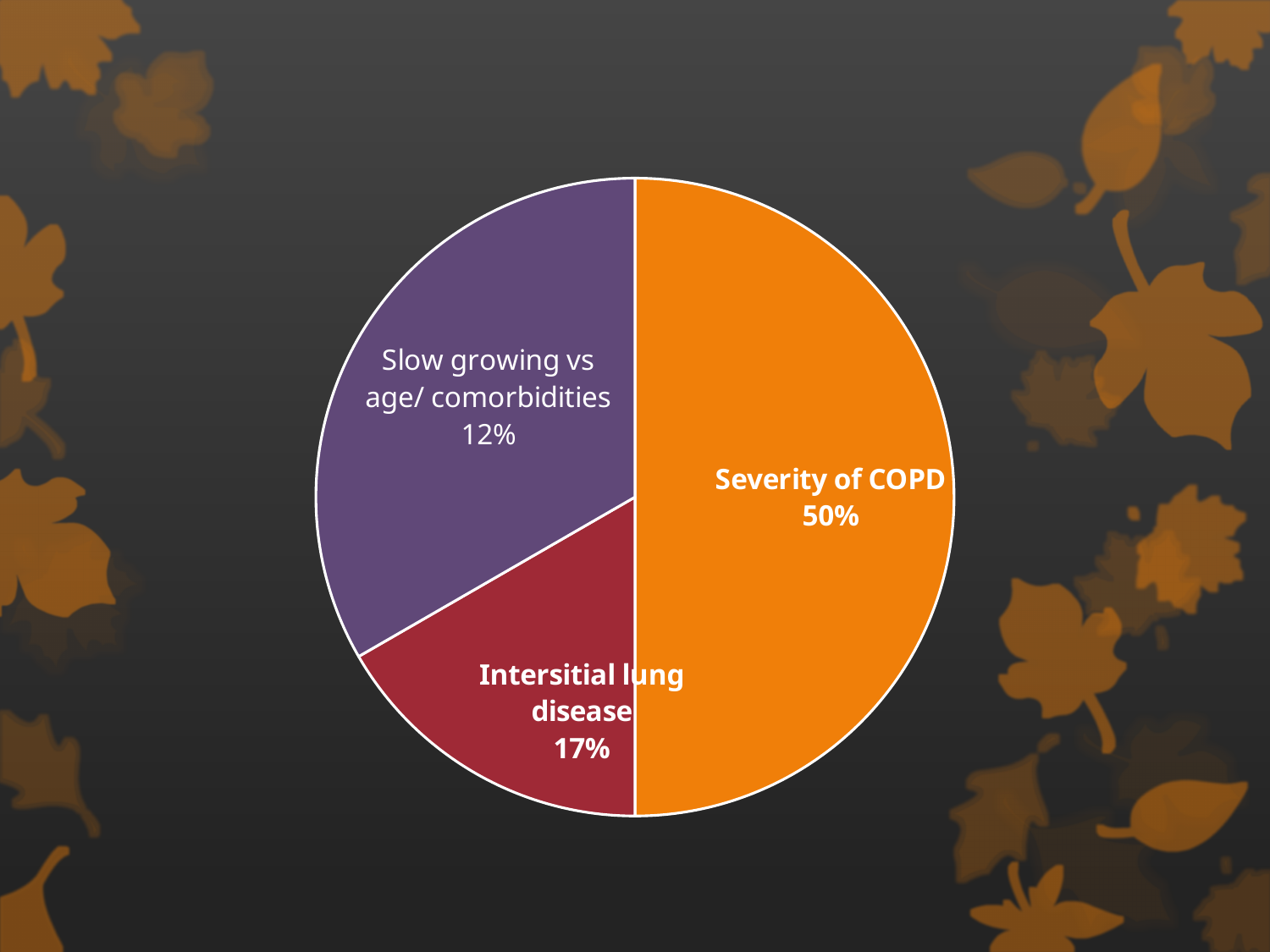
What colour is the Severity of COPD slice? orange What is the difference between the Severity of COPD percentage and the Slow growing vs age/ comorbidities percentage? 38% What kind of chart is shown on the slide? pie chart What is the difference between the Severity of COPD percentage and the Intersitial lung disease percentage? 33% What colour is the Intersitial lung disease slice? red How many slices does the pie chart have? 3 What percentage is shown for the Severity of COPD slice? 50% Which slice of the pie chart is the largest? Severity of COPD What percentage is shown for the Slow growing vs age/ comorbidities slice? 12% What share of the pie does the Severity of COPD slice represent? 50% What percentage is shown for the Intersitial lung disease slice? 17% Which is larger, the Severity of COPD slice or the Intersitial lung disease slice? Severity of COPD